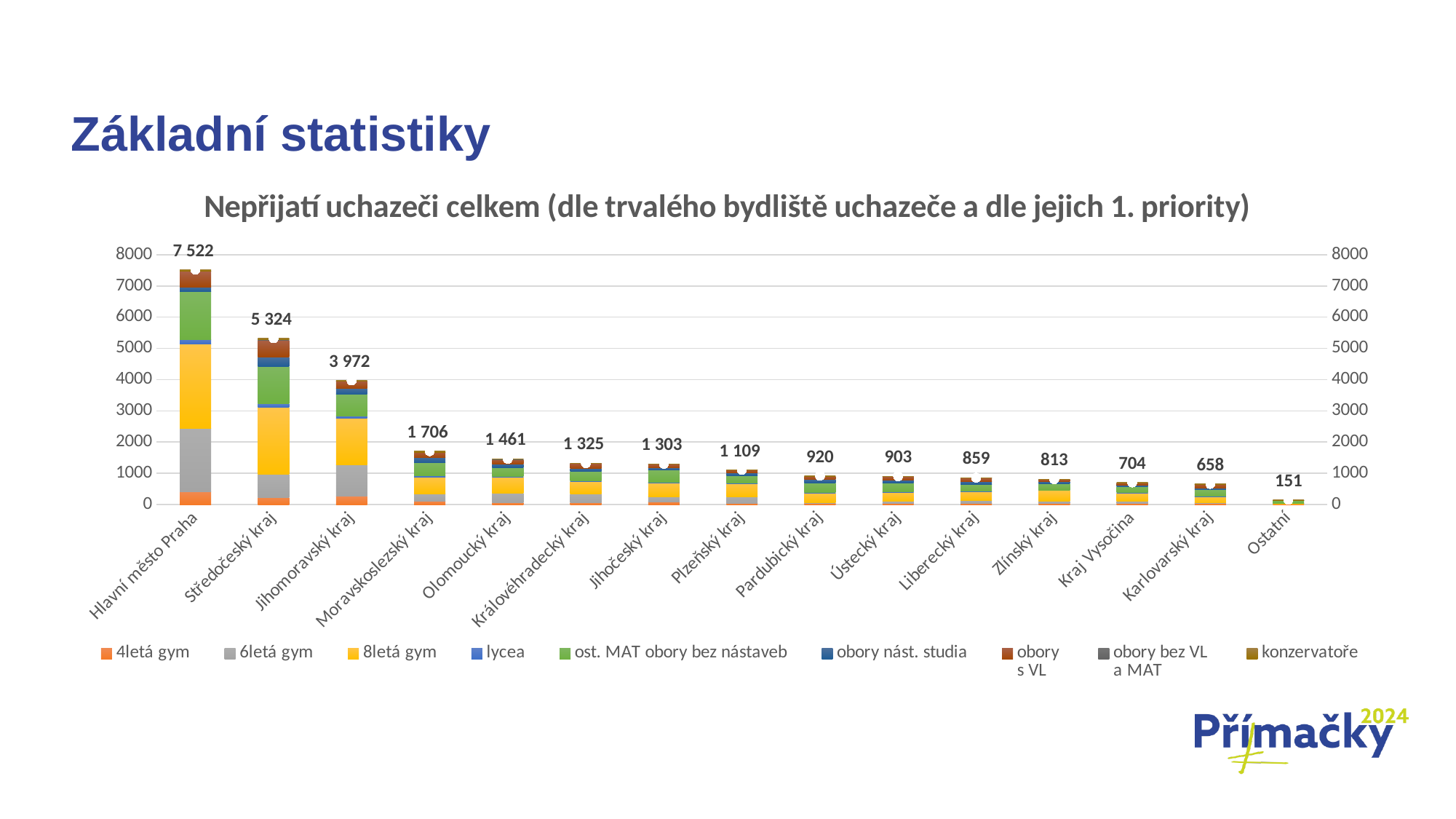
Do the bar totals rise or fall from left to right along the x axis? Fall Which category has the lowest total? Ostatní Which category has the highest total? Hlavní město Praha How many series does the legend list? 9 What is the total value labelled for Kraj Vysočina? 704 What kind of chart is shown on the slide? Stacked bar chart What is the total value labelled for Středočeský kraj? 5 324 What is the difference between the totals for Hlavní město Praha and Středočeský kraj? 2 198 How many categories are shown on the x axis? 15 What is the difference between the totals for Moravskoslezský kraj and Olomoucký kraj? 245 What is the total number of unaccepted applicants shown for Hlavní město Praha? 7 522 Which has a larger total, Jihočeský kraj or Plzeňský kraj? Jihočeský kraj